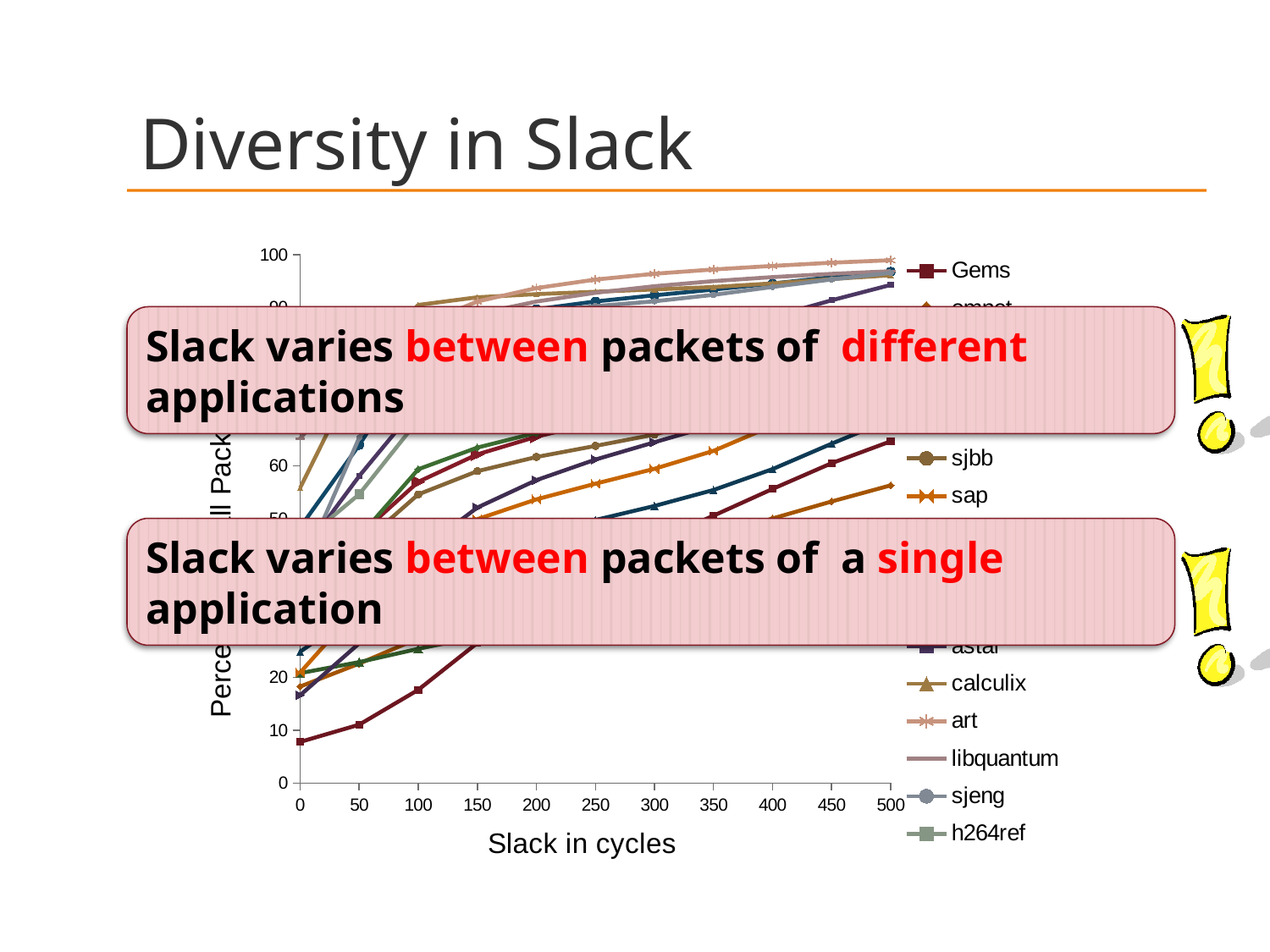
At a slack of 0 cycles, which series has the larger value, sap or Gems? sap At a slack of 500 cycles, which series has the larger value, art or sap? art Is the value for Gems at a slack of 0 cycles greater or less than 10? less As slack in cycles increases, does the Gems line rise or fall? rise Is the value for Gems at a slack of 500 cycles greater or less than 60? greater Is the value for sap at a slack of 500 cycles greater or less than 50? greater What is the label of the x axis of the chart? Slack in cycles How many tick values are labelled along the x axis of the chart? 11 What kind of chart is shown on the slide? line chart What is the highest value shown on the x axis of the chart? 500